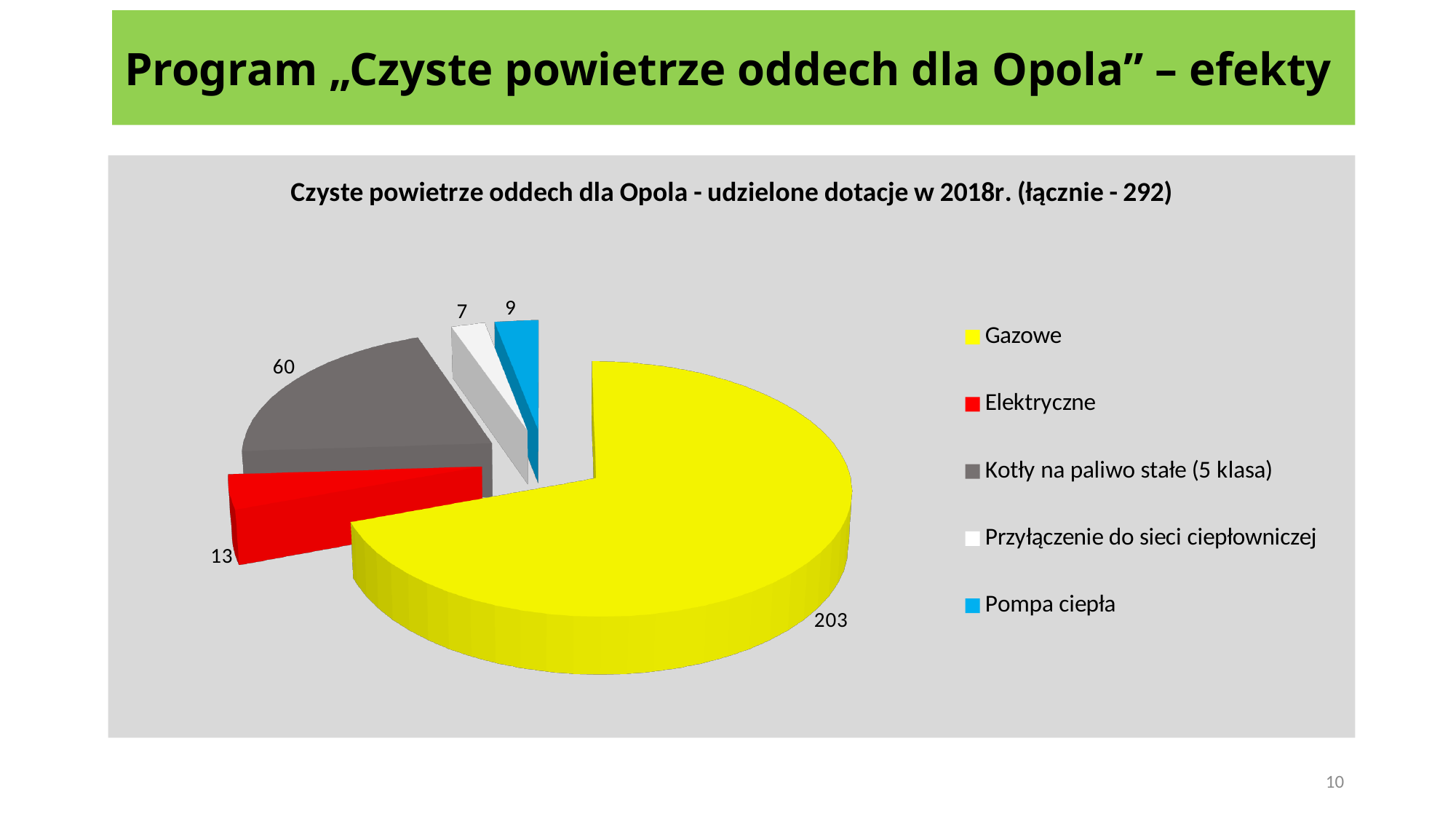
What is the difference between the values for Gazowe and Kotły na paliwo stałe (5 klasa)? 143 Which category has the smallest slice? Przyłączenie do sieci ciepłowniczej What type of chart is shown on the slide? pie chart What total number of grants is stated in the chart title? 292 What is the value for Gazowe? 203 What is the value for Elektryczne? 13 Which is larger, the value for Elektryczne or the value for Pompa ciepła? Elektryczne What is the value for Pompa ciepła? 9 Which category has the largest slice? Gazowe What is the value for Kotły na paliwo stałe (5 klasa)? 60 How many slices does the pie chart have? 5 How many entries does the legend list? 5